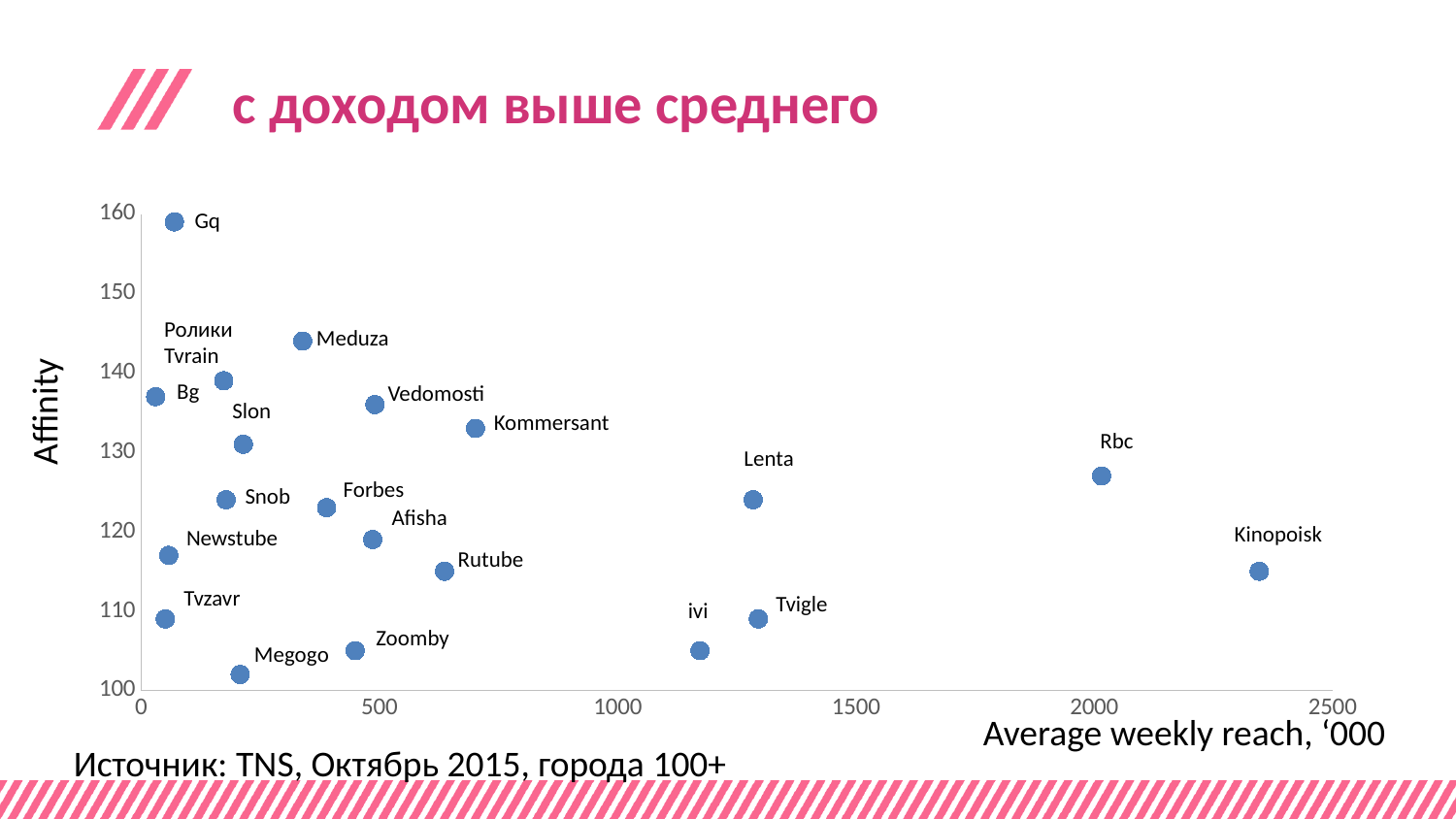
Is the average weekly reach for Lenta greater or less than 1000? greater What is the label of the vertical axis? Affinity What kind of chart is shown on the slide? scatter chart Is the Affinity value for Rutube greater or less than 120? less Which point has the lowest Affinity value? Megogo Which has a higher Affinity value, Lenta or Tvigle? Lenta Which point has the highest average weekly reach? Kinopoisk Which has a larger average weekly reach, Rbc or Kinopoisk? Kinopoisk Is the Affinity value for Gq greater or less than 150? greater How many data points are plotted on the chart? 20 Which point has the highest Affinity value? Gq